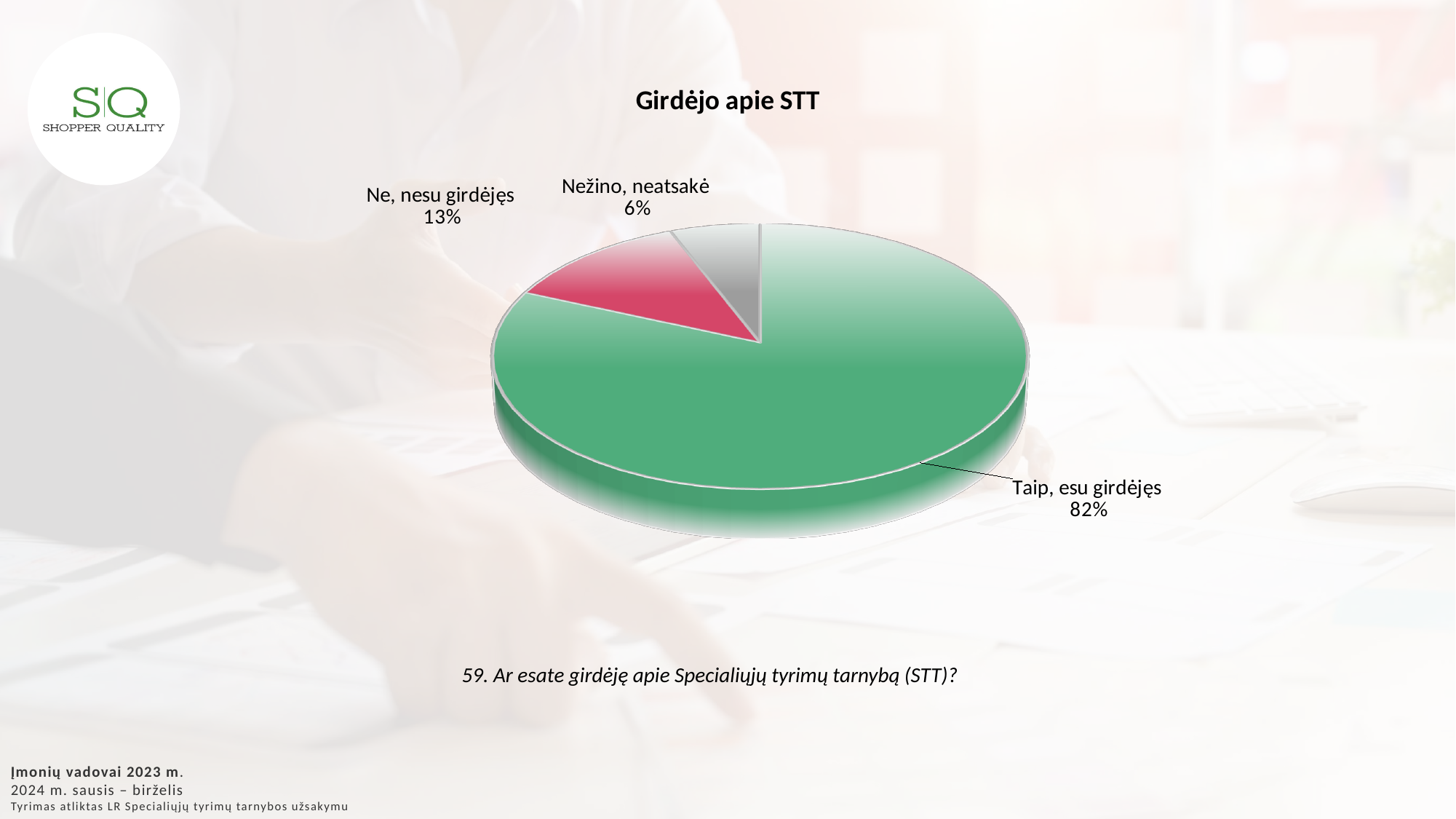
How many slices does the pie chart have? 3 What colour is the 'Taip, esu girdėjęs' slice? green What share of the pie is 'Taip, esu girdėjęs'? 82% What share of the pie is 'Ne, nesu girdėjęs'? 13% Which category has the smallest share of the pie? Nežino, neatsakė Which is larger, the share for 'Ne, nesu girdėjęs' or the share for 'Nežino, neatsakė'? Ne, nesu girdėjęs What is the difference in percentage points between 'Taip, esu girdėjęs' and 'Ne, nesu girdėjęs'? 69 What is the title of the chart? Girdėjo apie STT What share of the pie is 'Nežino, neatsakė'? 6% Which category has the largest share of the pie? Taip, esu girdėjęs What kind of chart is shown on the slide? pie chart What is the difference in percentage points between 'Ne, nesu girdėjęs' and 'Nežino, neatsakė'? 7